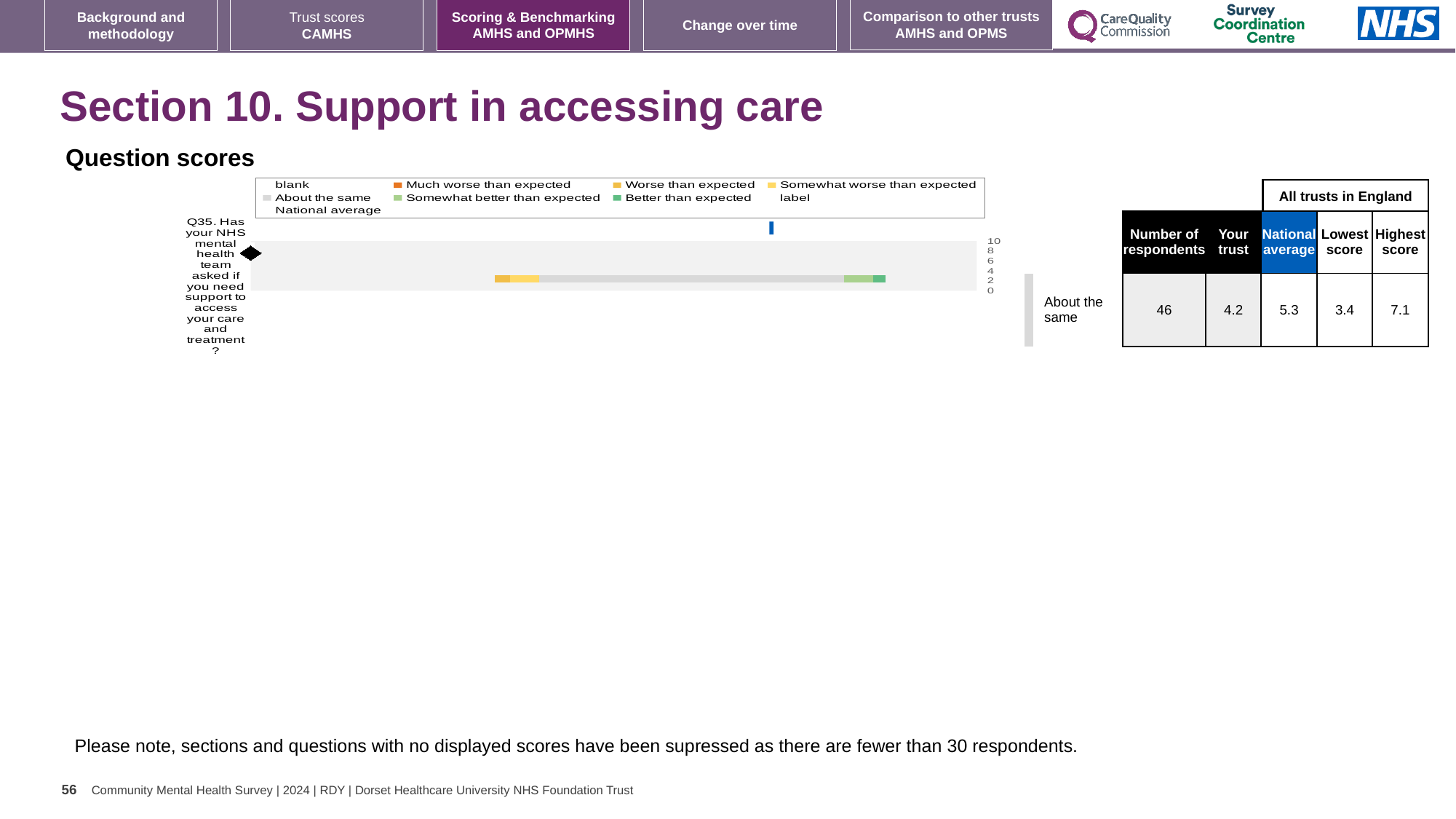
In the table beside the chart, what is the difference between the highest score and the lowest score for Q35? 3.7 In the table beside the chart, what is the number of respondents for Q35? 46 How many entries does the legend of the Question scores chart list? 9 What is the highest value shown on the axis of the Question scores chart? 10 How many questions (categories) are plotted in the Question scores chart? 1 What benchmark category label is shown to the right of the Q35 bar? About the same In the table beside the chart, is the 'Your trust' score for Q35 higher or lower than the national average? lower Which question is plotted in the Question scores chart? Q35. Has your NHS mental health team asked if you need support to access your care and treatment? In the table beside the chart, what is the 'Your trust' score for Q35? 4.2 In the table beside the chart, what is the highest score among all trusts in England for Q35? 7.1 What kind of chart is shown under 'Question scores'? bar chart In the table beside the chart, what is the national average for Q35? 5.3